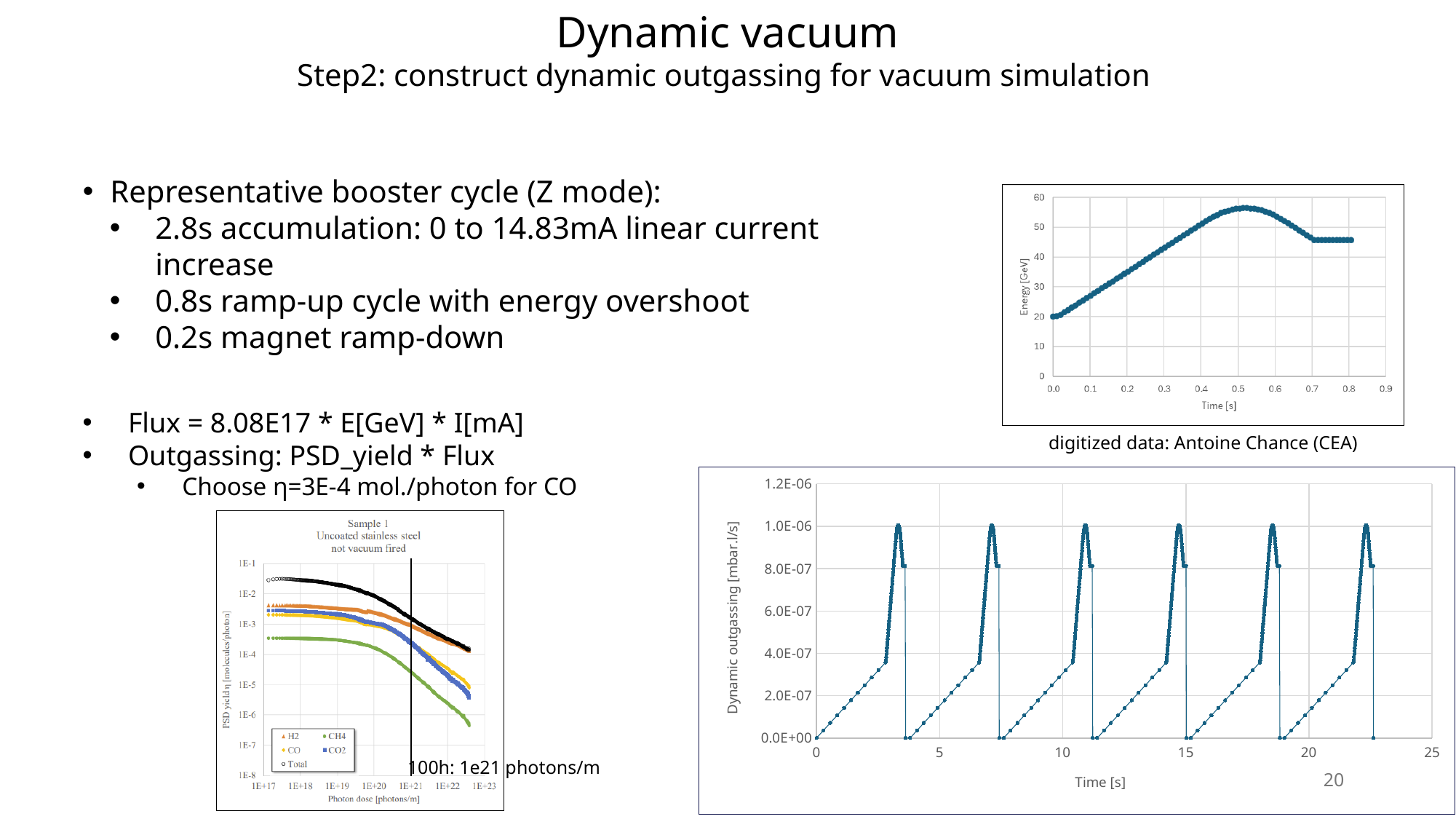
In the bottom-left chart (PSD yield vs Photon dose), which series has the lowest PSD yield across the photon dose range? CH4 In the bottom-left chart (PSD yield vs Photon dose), how many series does the legend list? 5 In the bottom-right chart (Dynamic outgassing vs Time), what is the peak value of the dynamic outgassing? 1.0E-06 In the bottom-right chart (Dynamic outgassing vs Time), is the plateau value after each peak greater or less than 6.0E-07? greater In the top-right chart (Energy vs Time), what is the label of the y axis? Energy [GeV] In the top-right chart (Energy vs Time), is the peak energy greater or less than 50 GeV? greater In the bottom-left chart (PSD yield vs Photon dose), which series has the highest PSD yield across the photon dose range? Total In the top-right chart (Energy vs Time), does the energy rise or fall between time 0.0 s and 0.5 s? rise In the top-right chart (Energy vs Time), is the energy at time 0.8 s greater or less than 50 GeV? less How many charts are shown on the slide? 3 In the bottom-right chart (Dynamic outgassing vs Time), what is the label of the x axis? Time [s] In the bottom-right chart (Dynamic outgassing vs Time), how many peaks (cycles) are plotted? 6